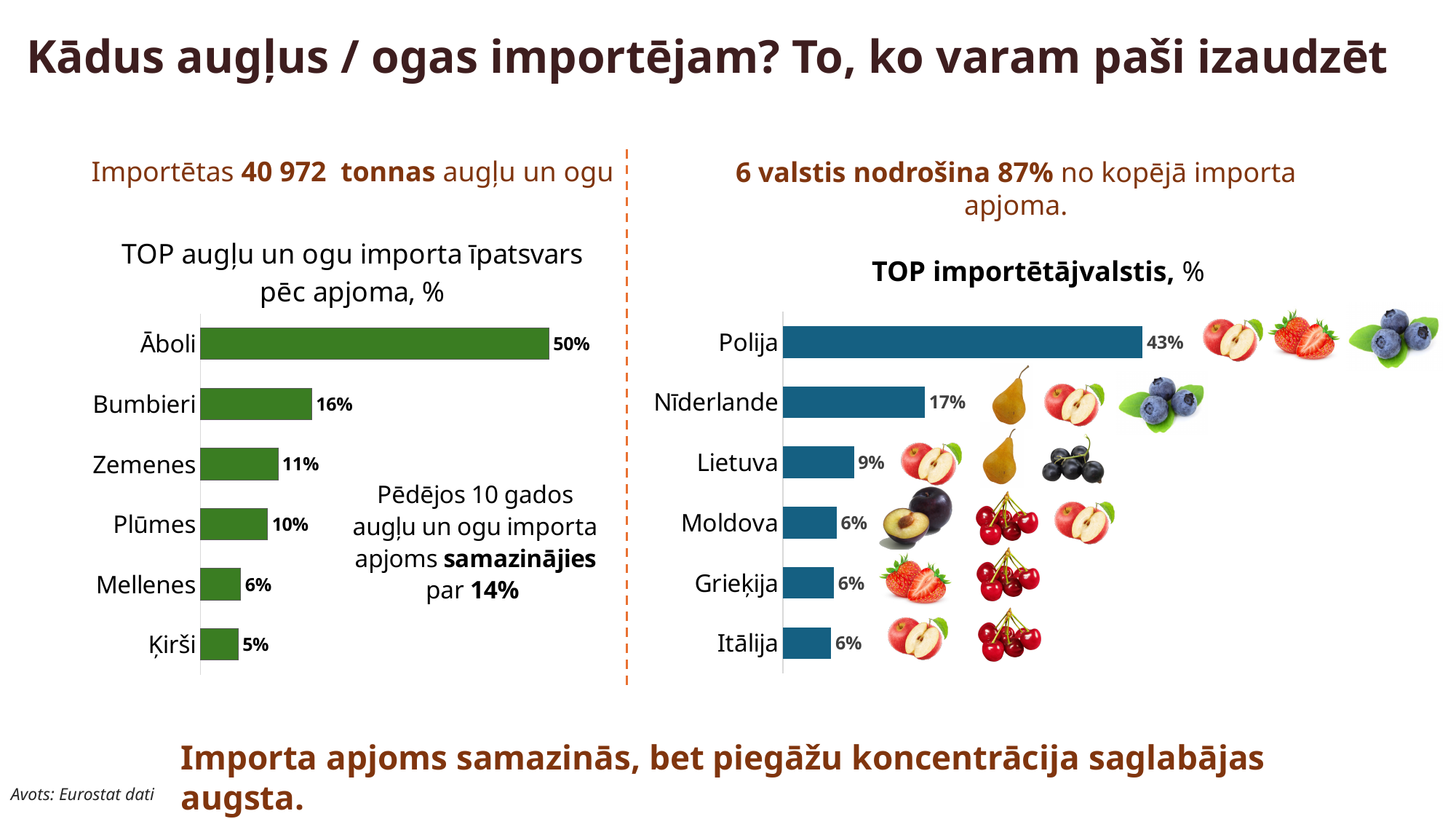
In the right chart (TOP importētājvalstis, %), how many countries are shown? 6 In the left chart (TOP augļu un ogu importa īpatsvars pēc apjoma, %), how many categories are shown? 6 In the left chart (TOP augļu un ogu importa īpatsvars pēc apjoma, %), what is the value for Plūmes? 10% What kind of chart is the right chart (TOP importētājvalstis, %)? Bar chart In the left chart (TOP augļu un ogu importa īpatsvars pēc apjoma, %), what is the value for Āboli? 50% In the right chart (TOP importētājvalstis, %), which country has the highest value? Polija In the left chart (TOP augļu un ogu importa īpatsvars pēc apjoma, %), which category has the lowest value? Ķirši In the right chart (TOP importētājvalstis, %), what is the value for Polija? 43% In the right chart (TOP importētājvalstis, %), what is the difference between Polija and Nīderlande? 26% In the right chart (TOP importētājvalstis, %), what is the value for Lietuva? 9% In the left chart (TOP augļu un ogu importa īpatsvars pēc apjoma, %), what is the difference between Āboli and Bumbieri? 34% In the left chart (TOP augļu un ogu importa īpatsvars pēc apjoma, %), which is larger, Zemenes or Mellenes? Zemenes